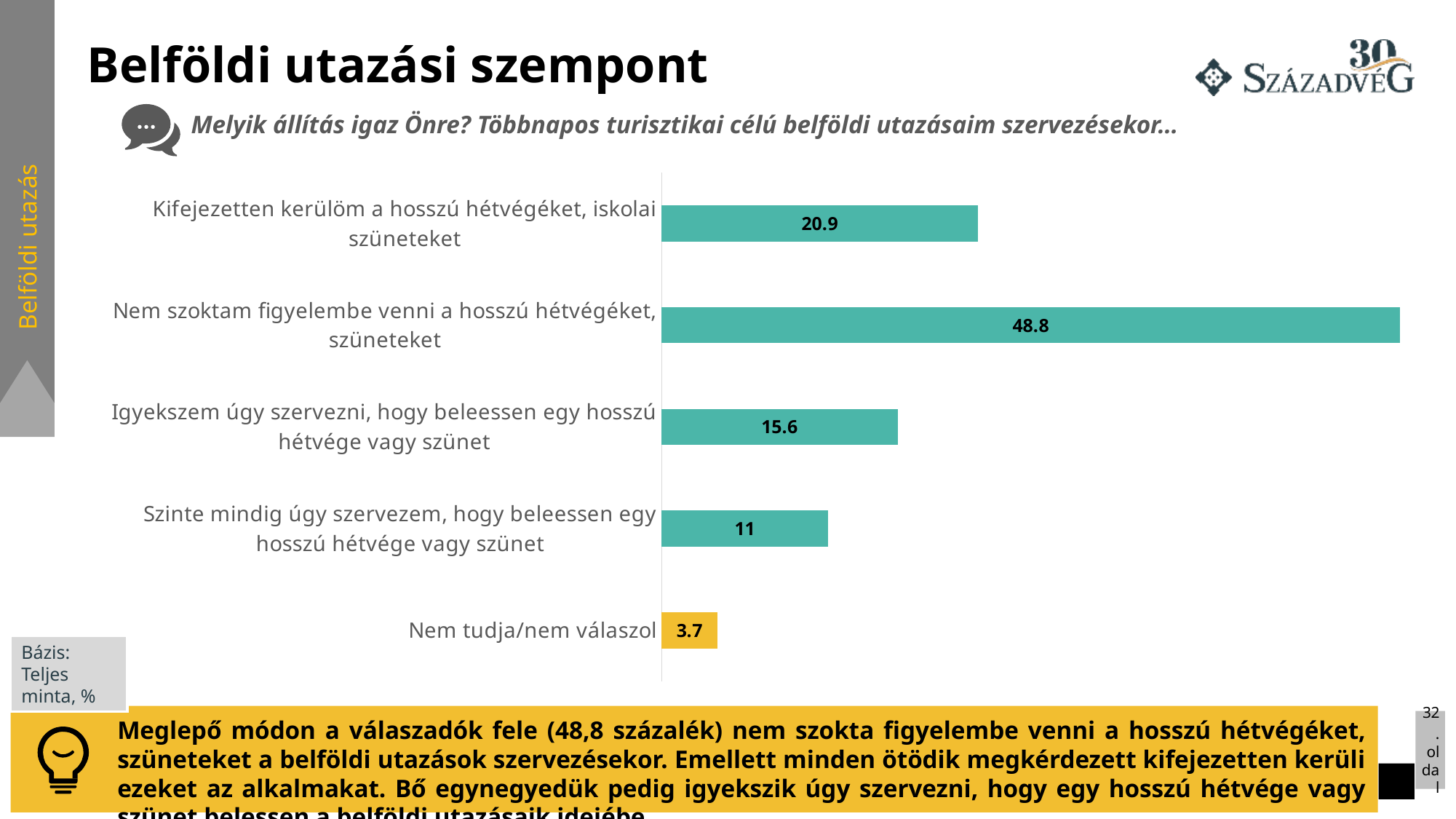
What is the value for "Szinte mindig úgy szervezem, hogy beleessen egy hosszú hétvége vagy szünet"? 11 What is the difference between the values for "Nem szoktam figyelembe venni a hosszú hétvégéket, szüneteket" and "Kifejezetten kerülöm a hosszú hétvégéket, iskolai szüneteket"? 27.9 What is the value for "Nem szoktam figyelembe venni a hosszú hétvégéket, szüneteket"? 48.8 What is the value for "Nem tudja/nem válaszol"? 3.7 What is the value for "Kifejezetten kerülöm a hosszú hétvégéket, iskolai szüneteket"? 20.9 Which is larger: the value for "Igyekszem úgy szervezni, hogy beleessen egy hosszú hétvége vagy szünet" or for "Szinte mindig úgy szervezem, hogy beleessen egy hosszú hétvége vagy szünet"? Igyekszem úgy szervezni, hogy beleessen egy hosszú hétvége vagy szünet What kind of chart is shown on the slide? Bar chart How many categories are shown in the chart? 5 Which bar is shown in a different colour (yellow) from the others? Nem tudja/nem válaszol What is the value for "Igyekszem úgy szervezni, hogy beleessen egy hosszú hétvége vagy szünet"? 15.6 Which category has the lowest value? Nem tudja/nem válaszol Which category has the highest value? Nem szoktam figyelembe venni a hosszú hétvégéket, szüneteket